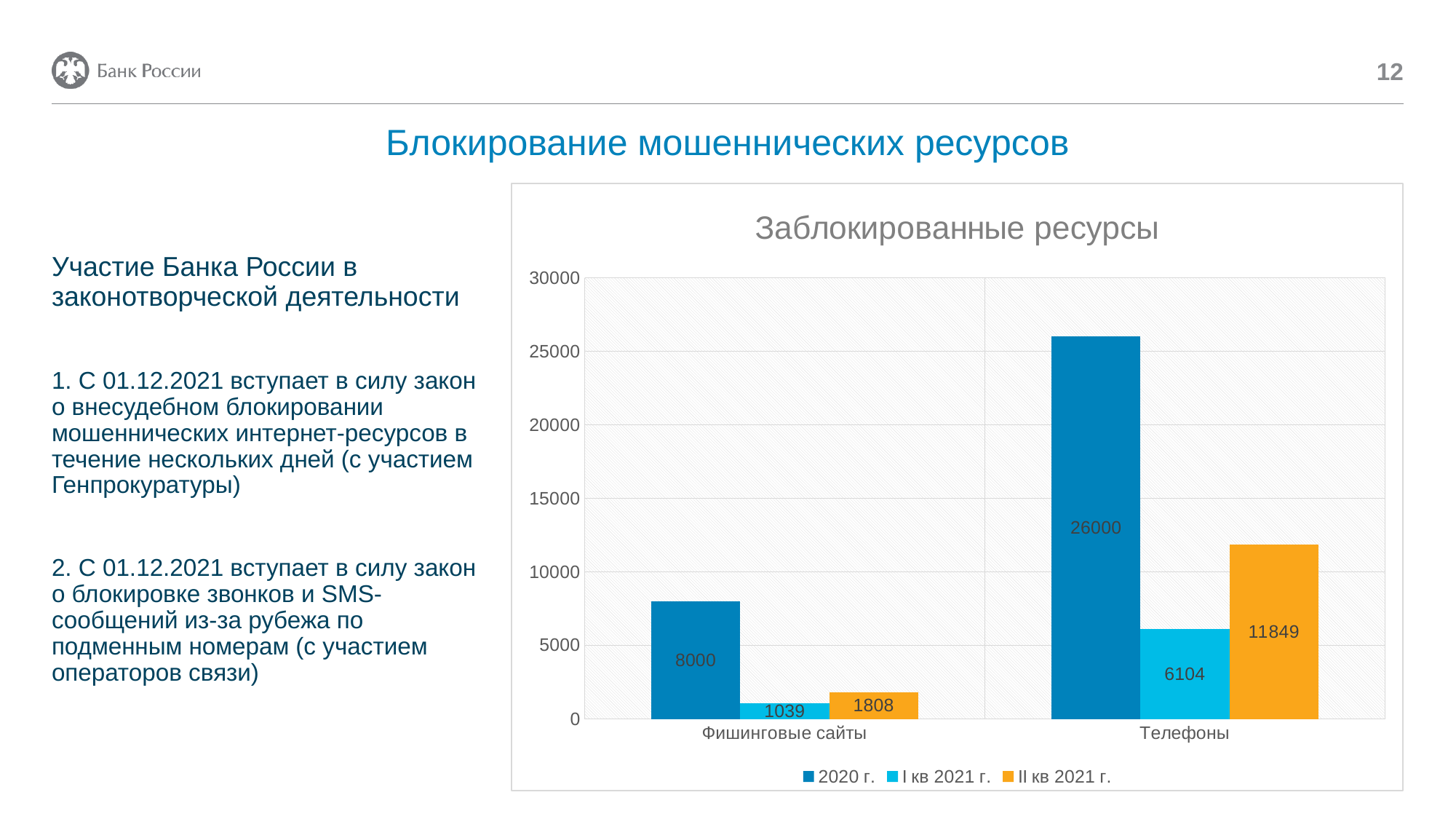
What type of chart is shown on the slide? Bar chart What is the difference between the II кв 2021 г. and I кв 2021 г. values for Телефоны? 5745 Which is larger for Фишинговые сайты: the 2020 г. value or the II кв 2021 г. value? 2020 г. What is the value for Телефоны in the II кв 2021 г. series? 11849 What is the title of the chart? Заблокированные ресурсы How many series does the legend list? 3 Which category has the highest value in the 2020 г. series? Телефоны Is the value for Телефоны in the 2020 г. series greater or less than 25000? greater Which series has the lowest value for Фишинговые сайты? I кв 2021 г. What is the value for Телефоны in the 2020 г. series? 26000 How many categories are shown on the x axis? 2 What is the value for Фишинговые сайты in the I кв 2021 г. series? 1039